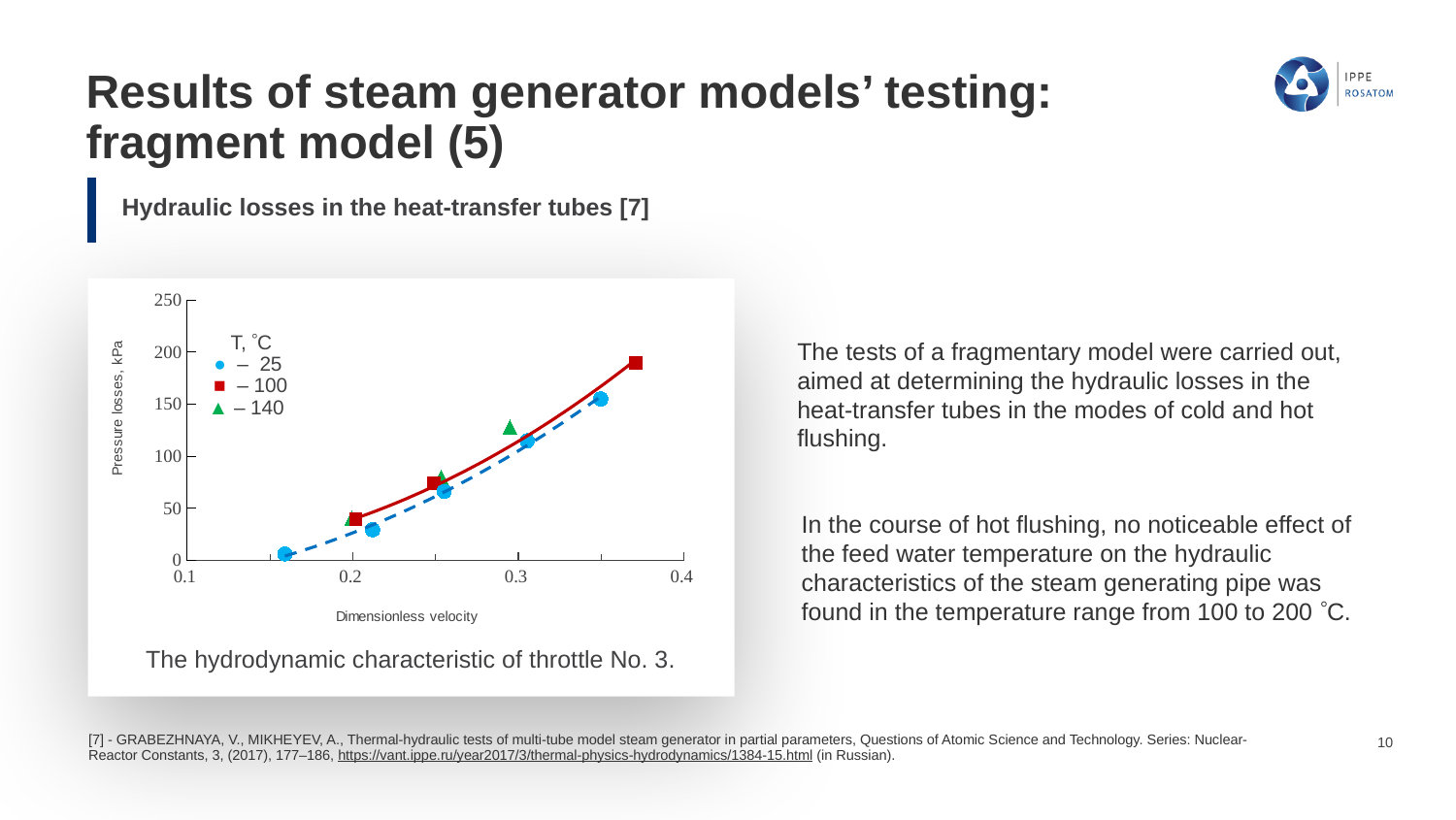
What kind of chart is shown on the slide? scatter chart Which series contains the point with the highest pressure loss on the chart? 100 °C Is the pressure loss for the red square near a dimensionless velocity of 0.25 greater or less than 100 kPa? less How many red square points (100 °C series) are plotted on the chart? 3 Is the pressure loss for the lowest blue circle (25 °C series) greater or less than 50 kPa? less Do the pressure losses rise or fall as the dimensionless velocity increases? rise How many series does the chart legend list? 3 Is the pressure loss for the green triangle near a dimensionless velocity of 0.3 greater or less than 100 kPa? greater What are the three temperature values listed in the chart legend? 25, 100, 140 What is the title of the vertical axis of the chart? Pressure losses, kPa Which is larger: the pressure loss of the rightmost red square or the rightmost blue circle? the rightmost red square